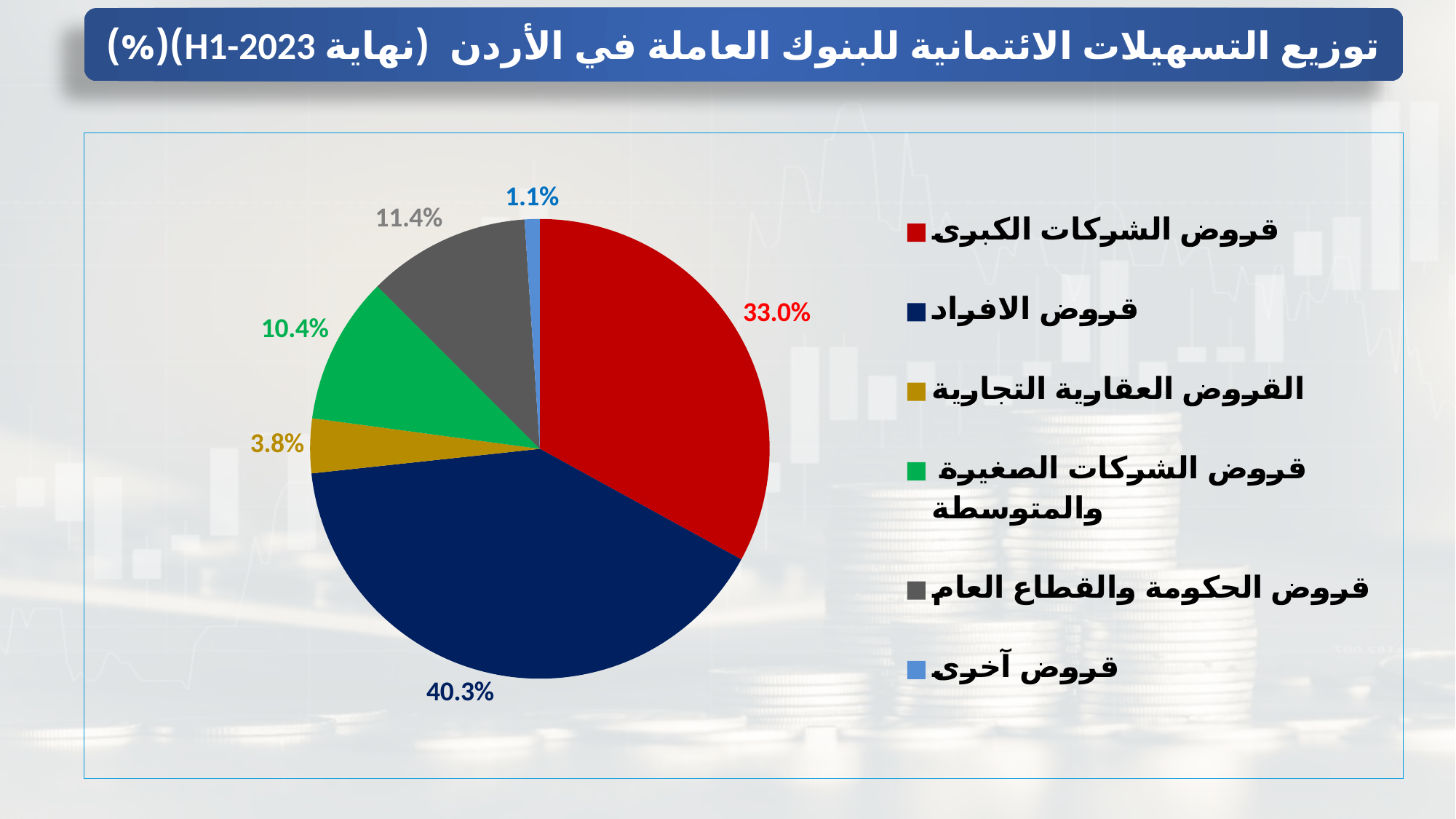
What percentage is shown for قروض الشركات الكبرى (large corporate loans)? 33.0% What colour represents قروض الشركات الصغيرة والمتوسطة in the pie chart? Green How many categories does the pie chart contain? 6 What type of chart is shown on the slide? Pie chart What percentage of credit facilities is shown for قروض الافراد (individual loans)? 40.3% Which is larger: the share for قروض الحكومة والقطاع العام or the share for قروض الشركات الصغيرة والمتوسطة? قروض الحكومة والقطاع العام What percentage is shown for قروض الحكومة والقطاع العام (government and public sector loans)? 11.4% What period does the chart title refer to? نهاية H1-2023 Which category has the largest share of the pie? قروض الافراد What percentage is shown for القروض العقارية التجارية (commercial real estate loans)? 3.8% What is the difference in percentage points between قروض الافراد and قروض الشركات الكبرى? 7.3 Which category has the smallest share of the pie? قروض آخرى